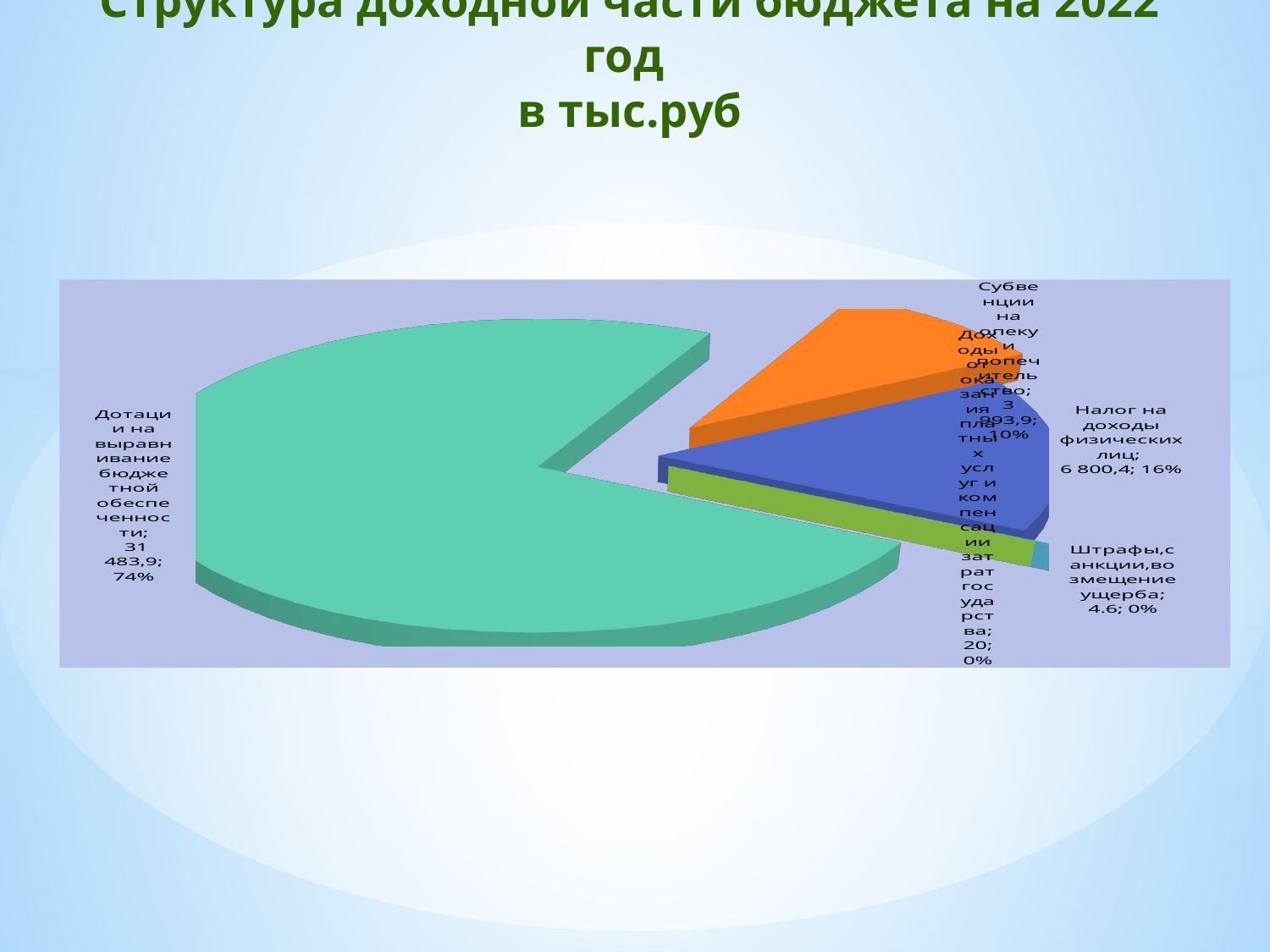
What value is shown for Штрафы,санкции,возмещение ущерба? 4.6 How many slices does the pie chart have? 5 What is the difference between the values for Дотации на выравнивание бюджетной обеспеченности and Налог на доходы физических лиц? 24 683,5 What kind of chart is shown on the slide? pie chart In what units are the values on the chart given, according to the slide title? тыс.руб What share of the pie does Субвенции на опеку и попечительство take? 10% What value is shown for Дотации на выравнивание бюджетной обеспеченности? 31 483,9 Which is larger, Налог на доходы физических лиц or Субвенции на опеку и попечительство? Налог на доходы физических лиц Which category has the largest slice of the pie? Дотации на выравнивание бюджетной обеспеченности What share of the pie does Налог на доходы физических лиц take? 16% What value is shown for Налог на доходы физических лиц? 6 800,4 What share of the pie does Дотации на выравнивание бюджетной обеспеченности take? 74%